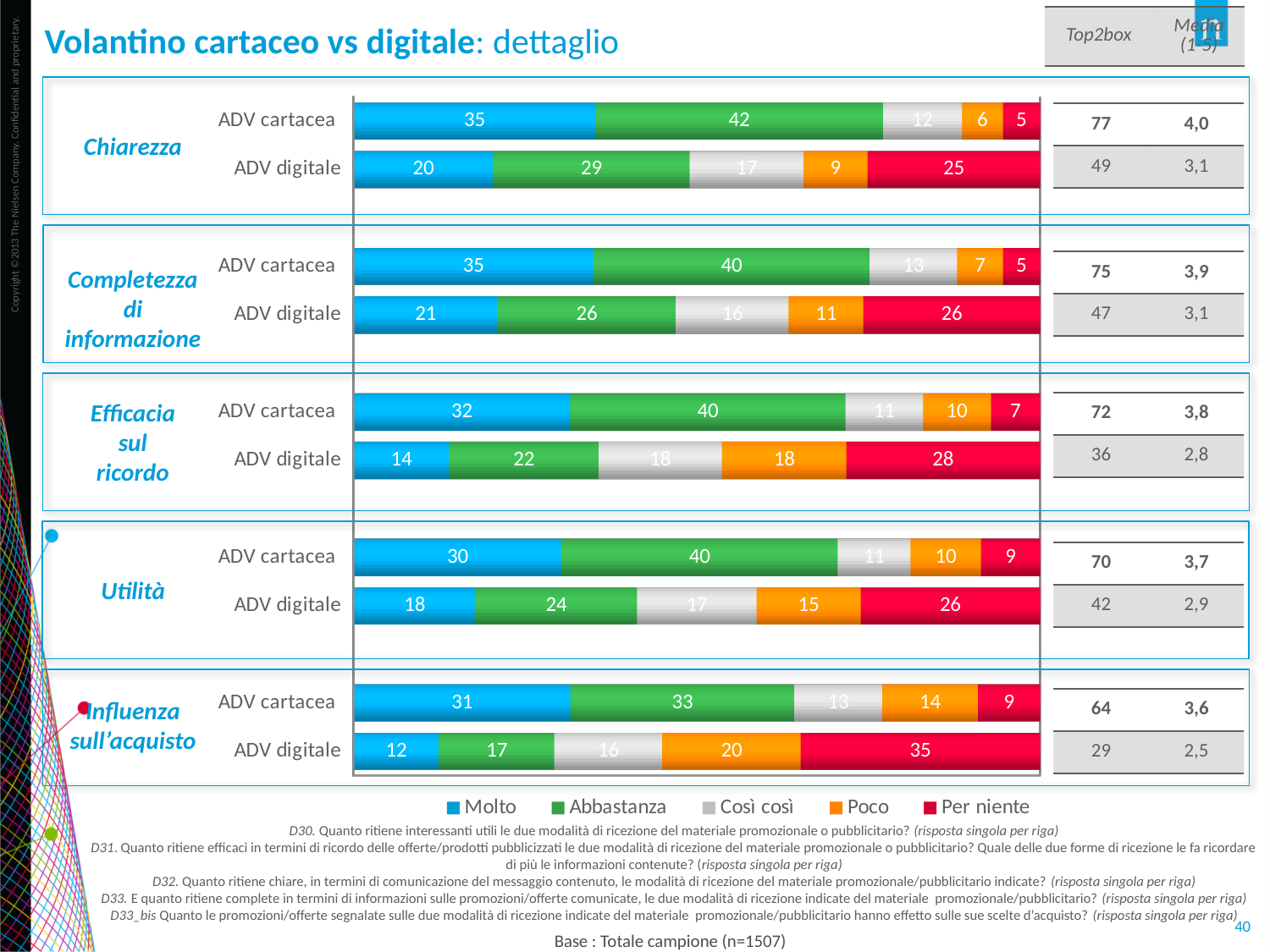
What is the total of the ADV cartacea stacked bar in the Completezza di informazione chart? 100 In the Chiarezza chart, what is the value of the Molto segment for ADV cartacea? 35 In the Utilità chart, what is the difference between the Molto values for ADV cartacea and ADV digitale? 12 What kind of chart is used for the Utilità section? Stacked bar chart In the Influenza sull'acquisto chart, which segment is the largest in the ADV digitale bar? Per niente In the Chiarezza chart, which segment is the smallest in the ADV cartacea bar? Per niente In the Efficacia sul ricordo chart, which bar has the larger Abbastanza value, ADV cartacea or ADV digitale? ADV cartacea In the Efficacia sul ricordo chart, what is the value of the Poco segment for ADV cartacea? 10 In the Chiarezza chart, what is the value of the Per niente segment for ADV digitale? 25 In the Completezza di informazione chart, what is the value of the Abbastanza segment for ADV digitale? 26 In the Influenza sull'acquisto chart, what is the value of the Per niente segment for ADV digitale? 35 How many series does the legend list for the charts on this slide? 5